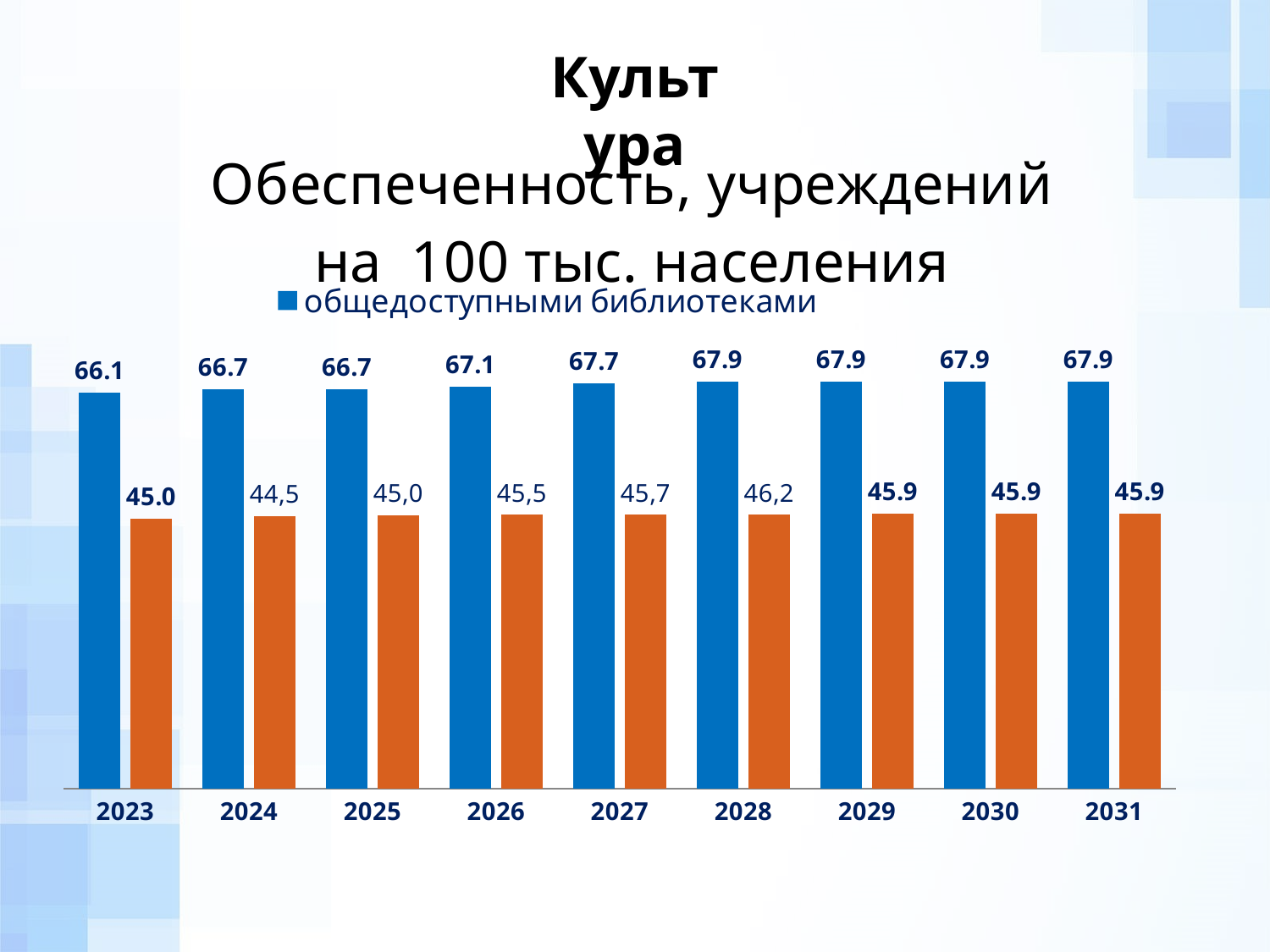
In which year is the blue bar (общедоступными библиотеками) lowest? 2023 What is the value of the orange bar for 2028? 46,2 What is the value of the orange bar for 2024? 44,5 What is the difference between the blue bar and the orange bar in 2023? 21.1 Which is larger in 2026: the blue bar or the orange bar? the blue bar What is the value of the blue bar (общедоступными библиотеками) for 2023? 66.1 How many series does the legend list? 1 What is the value of the blue bar (общедоступными библиотеками) for 2027? 67.7 What kind of chart is shown on the slide? bar chart How many years are shown on the x axis? 9